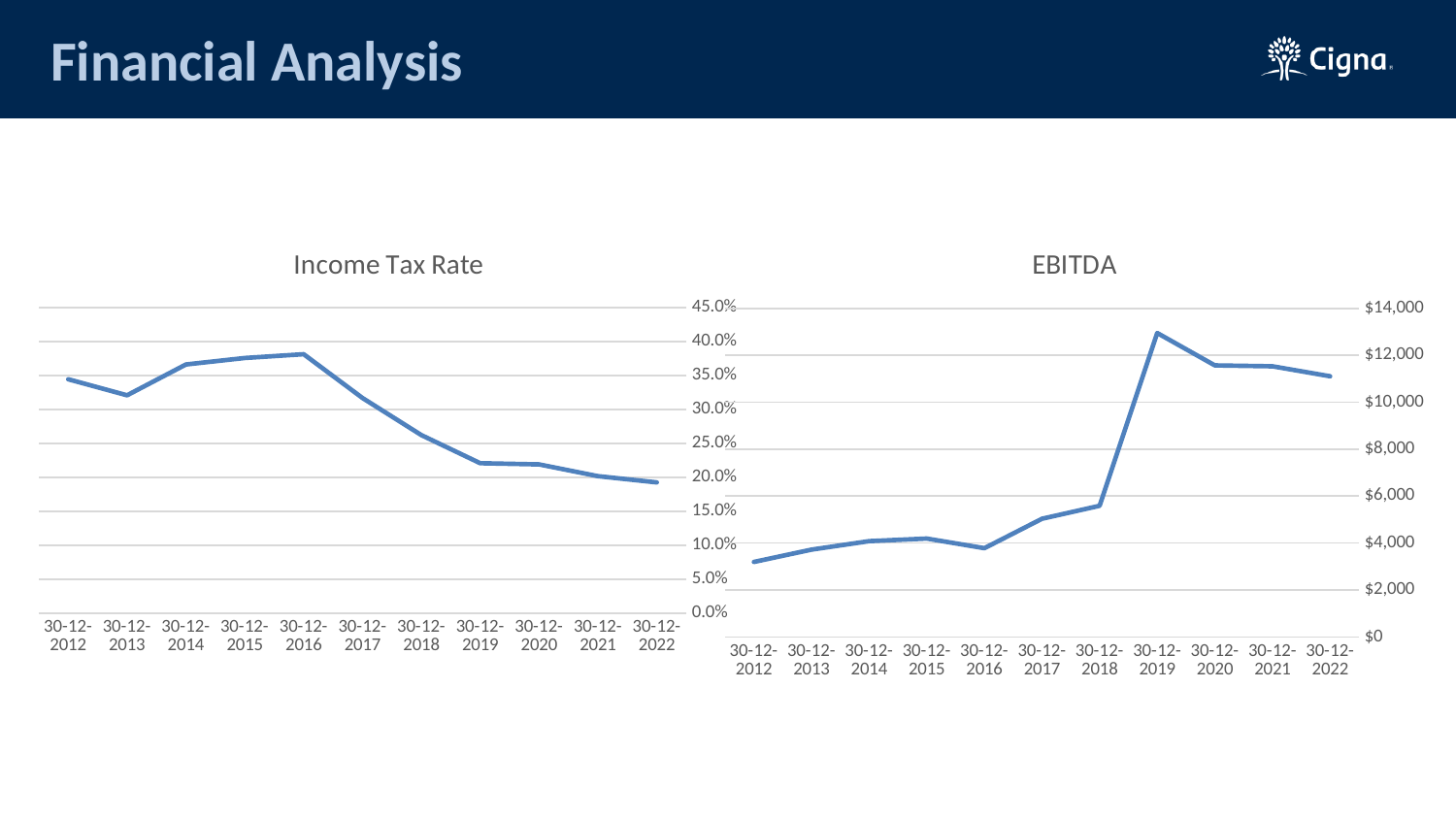
On the Income Tax Rate chart, is the value for 30-12-2016 greater or less than 35.0%? greater How many data points are plotted on the EBITDA chart? 11 On the Income Tax Rate chart, do the values generally rise or fall from 30-12-2016 to 30-12-2022? fall On the EBITDA chart, is the value for 30-12-2019 greater or less than $12,000? greater On the EBITDA chart, which year has the highest value? 30-12-2019 On the EBITDA chart, which year has the lowest value? 30-12-2012 On the Income Tax Rate chart, which is larger, the value for 30-12-2014 or the value for 30-12-2019? 30-12-2014 What kind of chart is the Income Tax Rate chart? line chart On the Income Tax Rate chart, which year has the highest value? 30-12-2016 What kind of chart is the EBITDA chart? line chart On the EBITDA chart, is the value for 30-12-2018 greater or less than $6,000? less